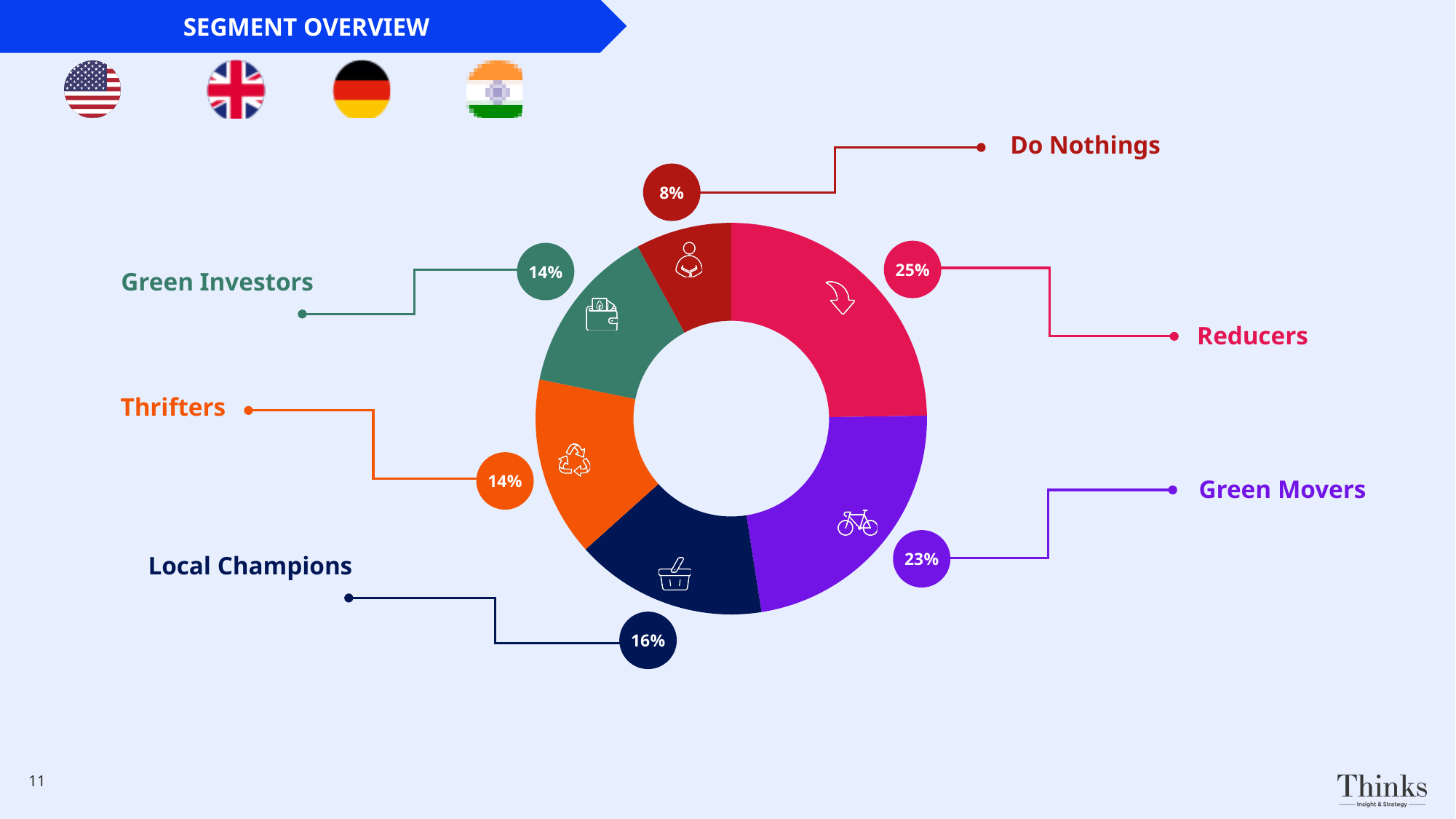
What percentage is shown for Do Nothings? 8% Which segment has the smallest share in the chart? Do Nothings What is the difference in percentage points between Local Champions and Do Nothings? 8 What share of the donut chart do Reducers account for? 25% What percentage is shown for Green Movers? 23% What percentage is shown for Local Champions? 16% Which segment has the largest share in the chart? Reducers Which is larger, the share for Green Movers or the share for Local Champions? Green Movers How many segments are shown in the donut chart? 6 What type of chart is shown on the slide? Donut (pie) chart Which two segments both have a share of 14%? Green Investors and Thrifters What is the difference in percentage points between Reducers and Green Movers? 2